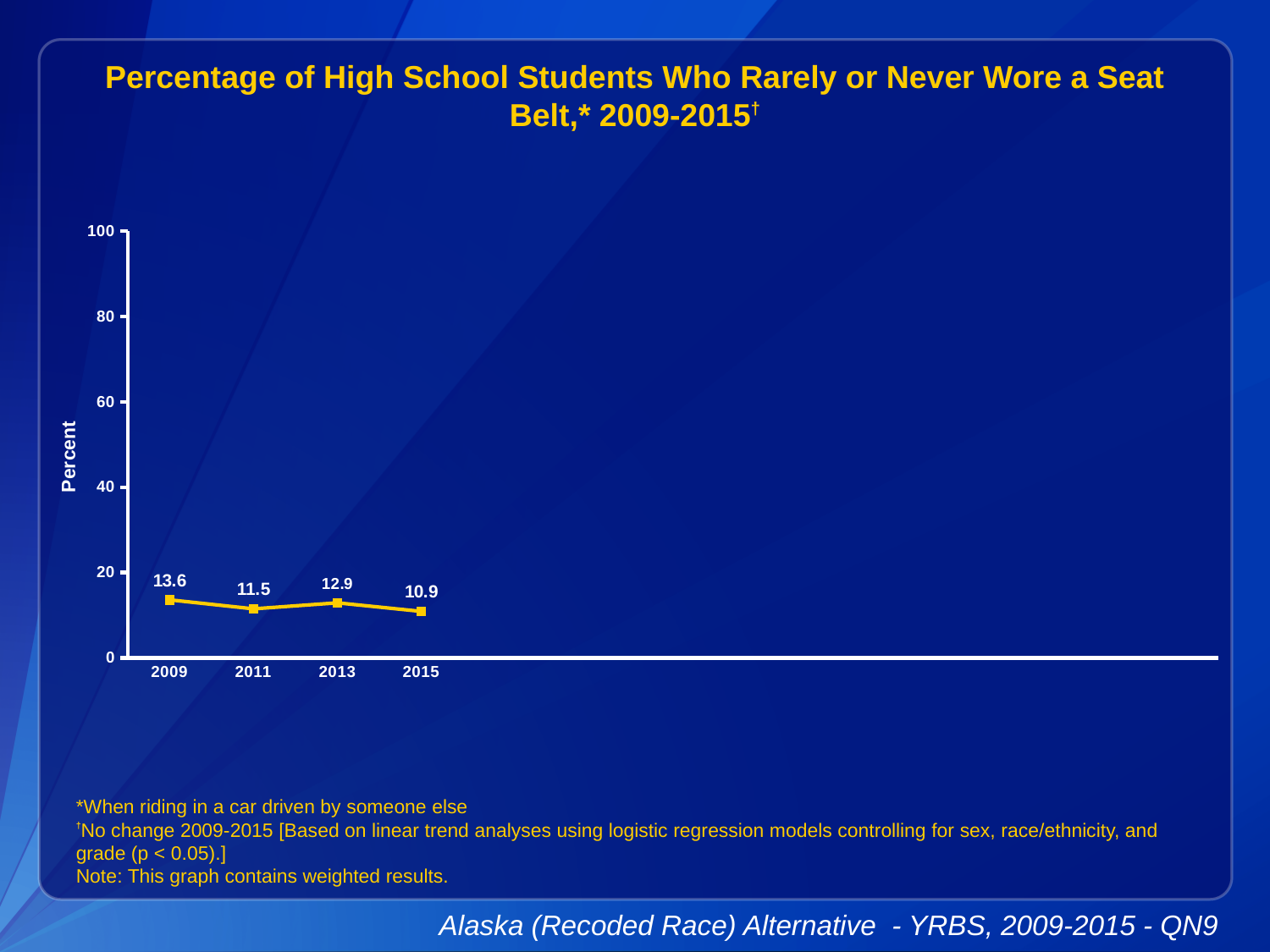
What is the value for 2013? 12.9 Which year has the lowest value? 2015 Which is larger, the value for 2011 or the value for 2013? 2013 Which year has the highest value? 2009 What is the label on the y axis? Percent What is the difference between the values for 2009 and 2015? 2.7 What kind of chart is shown? line chart What is the value for 2011? 11.5 How many years are plotted on the chart? 4 What is the value for 2009? 13.6 Is the value for 2009 greater or less than 20? less What is the value for 2015? 10.9